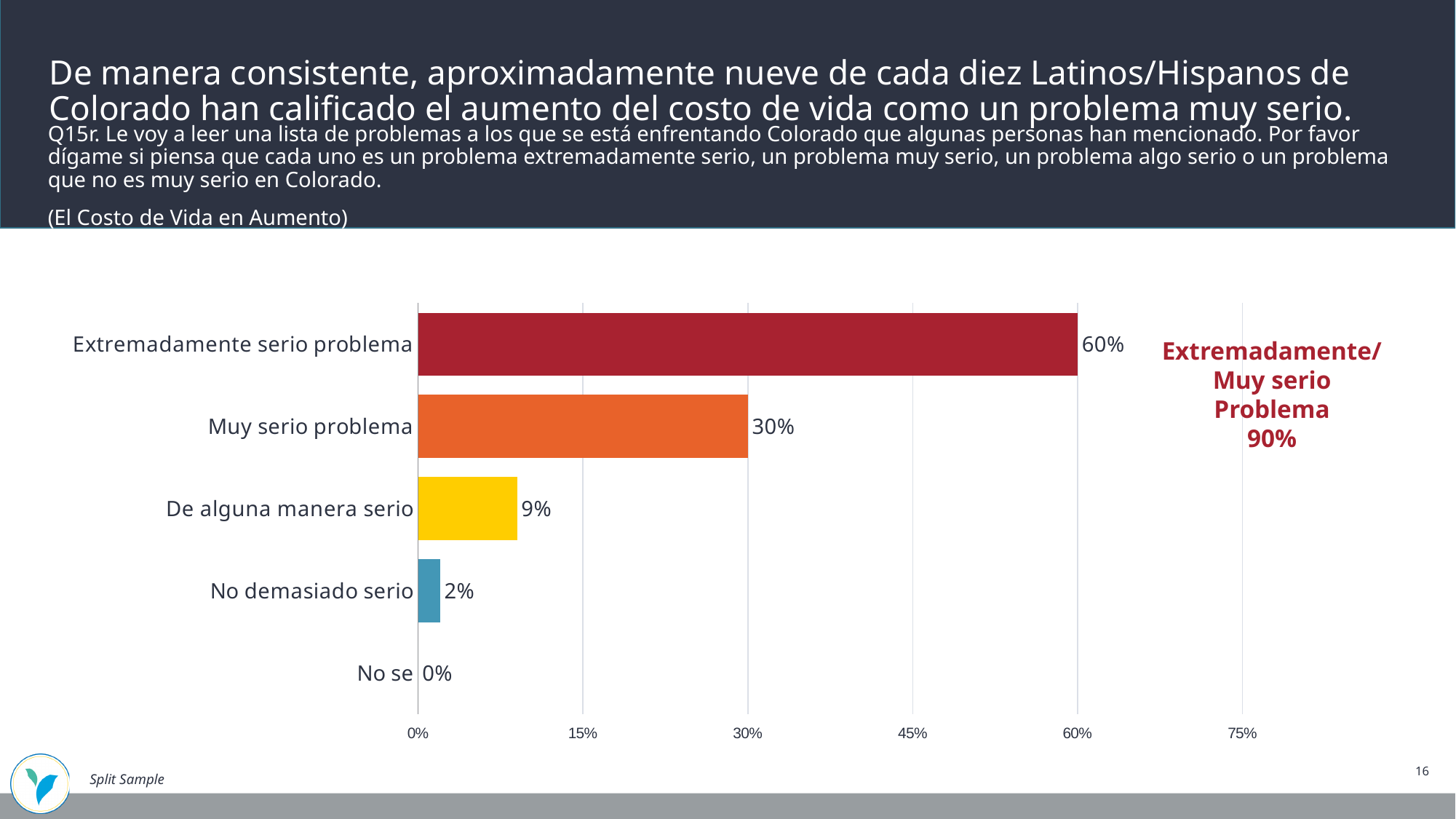
What kind of chart is shown on the slide? Bar chart What is the value for "Extremadamente serio problema"? 60% Which category has the highest value? Extremadamente serio problema What is the value for "De alguna manera serio"? 9% What is the value for "No demasiado serio"? 2% Which is larger, "De alguna manera serio" or "No demasiado serio"? De alguna manera serio Which category has the lowest value? No se What is the value for "No se"? 0% How many categories are shown in the chart? 5 What is the value for "Muy serio problema"? 30% What is the difference between "Extremadamente serio problema" and "Muy serio problema"? 30% What combined percentage is shown for "Extremadamente/Muy serio Problema" in the annotation next to the chart? 90%